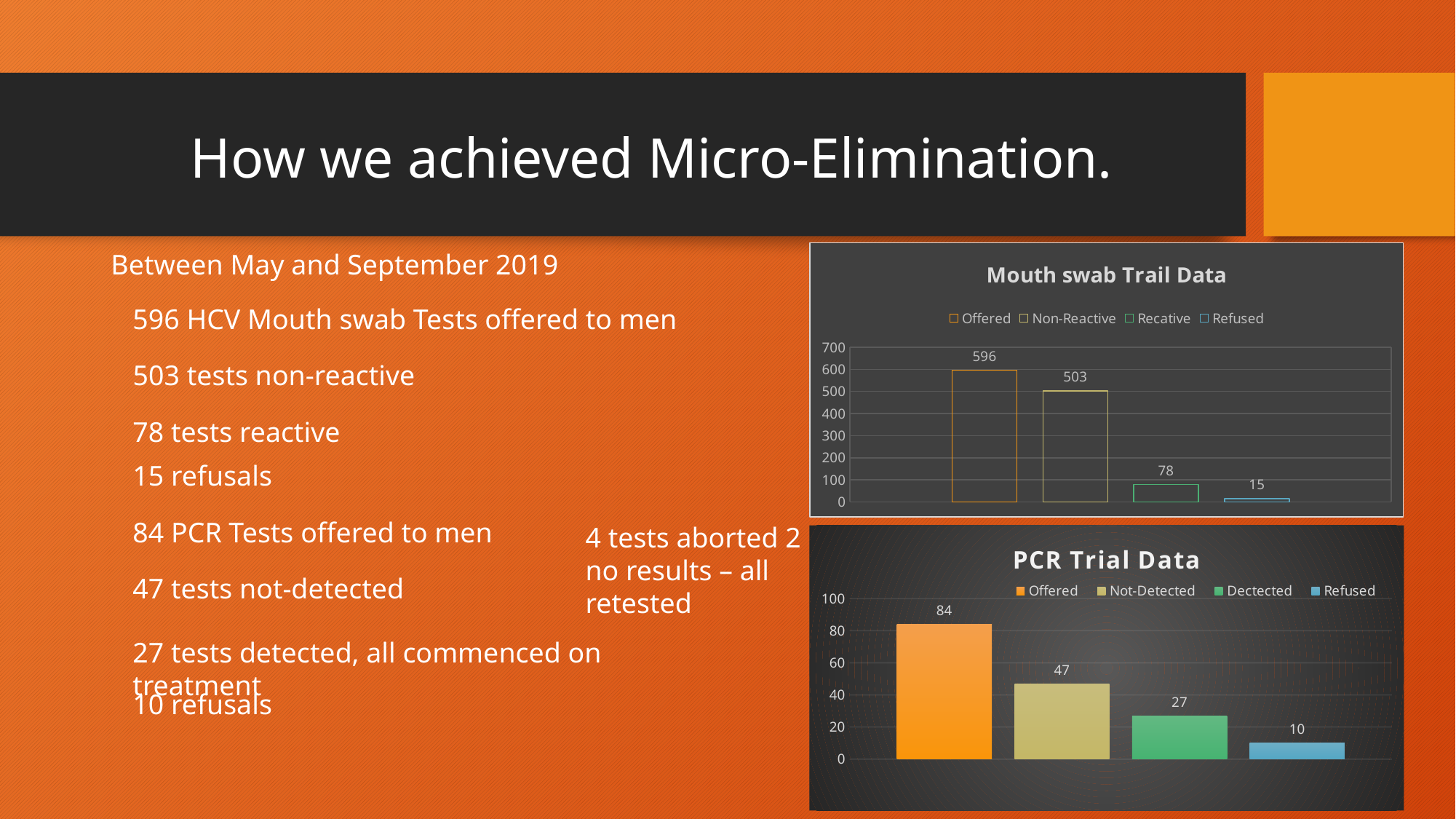
In the 'PCR Trial Data' chart, which is larger, Not-Detected or Dectected? Not-Detected In the 'Mouth swab Trail Data' chart, what is the difference between Offered and Non-Reactive? 93 In the 'PCR Trial Data' chart, what is the value for Not-Detected? 47 In the 'Mouth swab Trail Data' chart, what is the value for Non-Reactive? 503 In the 'PCR Trial Data' chart, what is the value for Refused? 10 What type of chart is the 'PCR Trial Data' chart? Bar chart In the 'Mouth swab Trail Data' chart, what is the value for Offered? 596 In the 'Mouth swab Trail Data' chart, which series has the lowest value? Refused In the 'PCR Trial Data' chart, what is the difference between Offered and Not-Detected? 37 In the 'Mouth swab Trail Data' chart, how many series does the legend list? 4 In the 'Mouth swab Trail Data' chart, is the value for Reactive greater or less than 100? less In the 'PCR Trial Data' chart, which series has the highest value? Offered